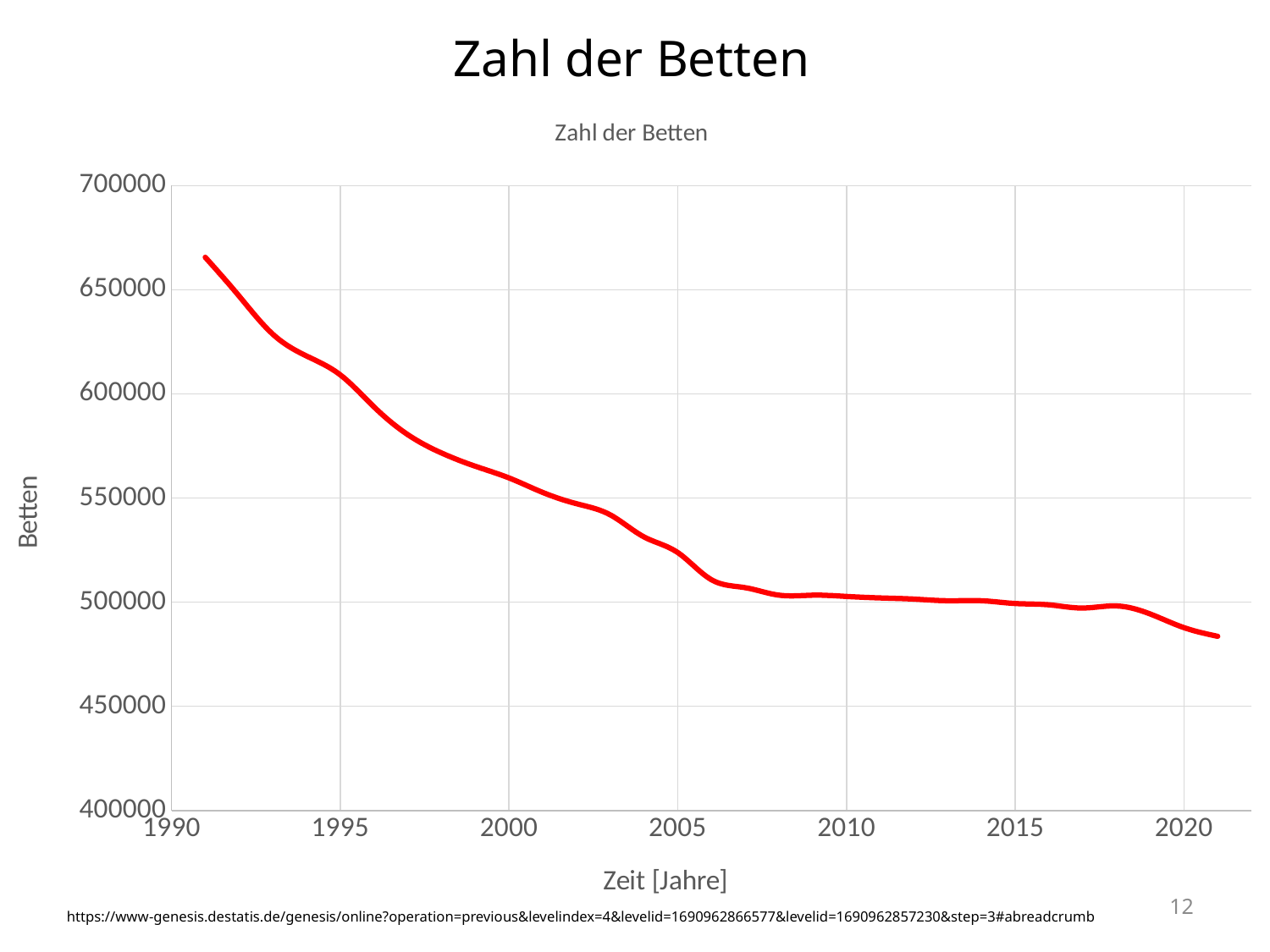
What is the label of the y axis? Betten Is the value for 1991 greater or less than 650000? greater What is the label of the x axis? Zeit [Jahre] Is the value for 2010 greater or less than 550000? less What kind of chart is shown on the slide? line chart Do the values rise or fall along the x axis from 1991 to 2021? fall Is the value for 1995 greater or less than 600000? greater In which year is the number of beds lowest? 2021 In which year is the number of beds highest? 1991 Which year has the larger value, 1995 or 2010? 1995